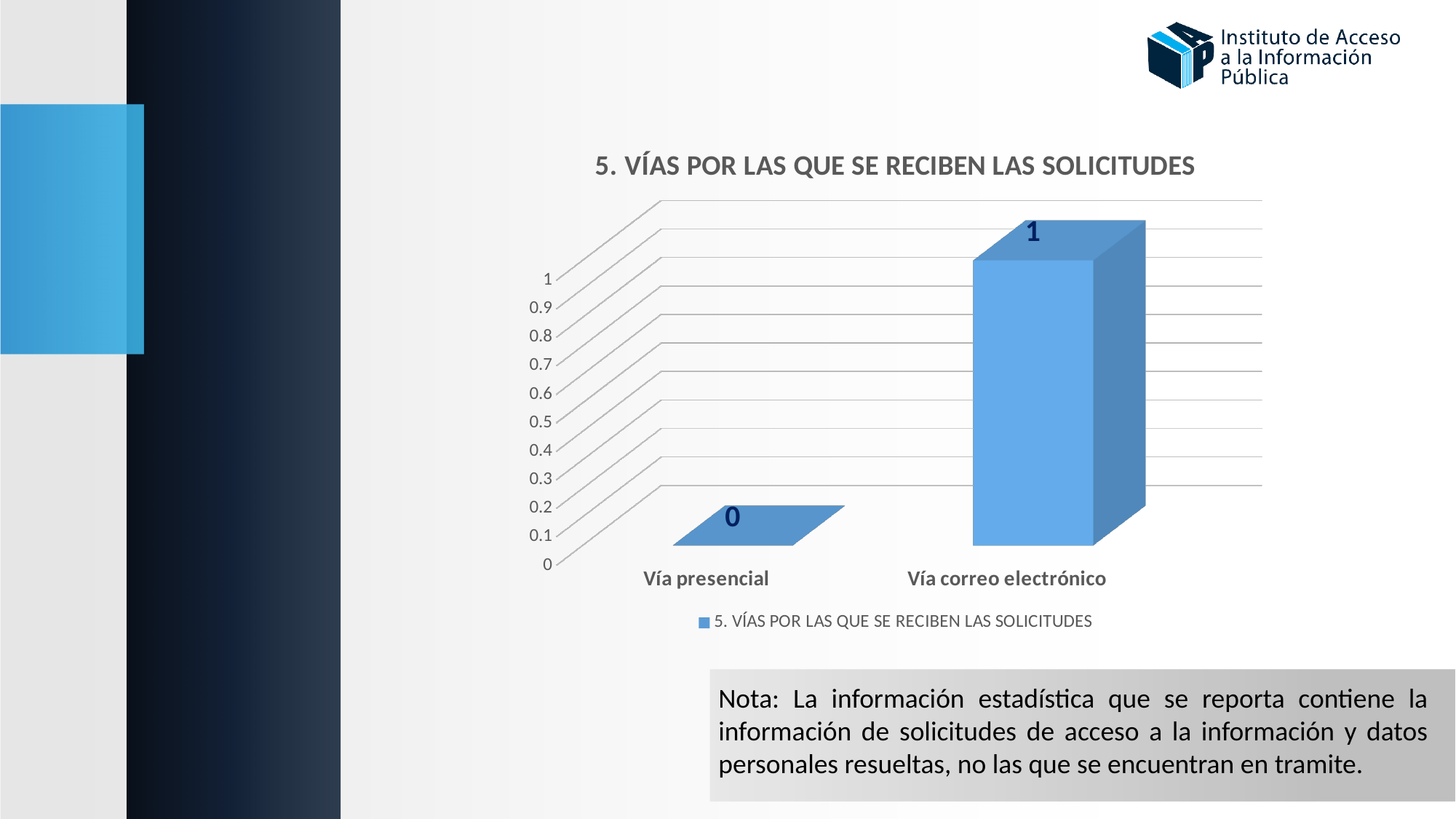
How many categories are shown on the x axis? 2 Is the value for Vía correo electrónico greater or less than 0.5? greater What is the title of the chart? 5. VÍAS POR LAS QUE SE RECIBEN LAS SOLICITUDES Which is larger, the value for Vía presencial or the value for Vía correo electrónico? Vía correo electrónico How many series does the legend list? 1 Which category has the highest value? Vía correo electrónico What is the value for Vía correo electrónico? 1 What is the difference between the values for Vía correo electrónico and Vía presencial? 1 Which category has the lowest value? Vía presencial What is the value for Vía presencial? 0 What kind of chart is shown on the slide? Bar chart What is the maximum value shown on the vertical axis? 1